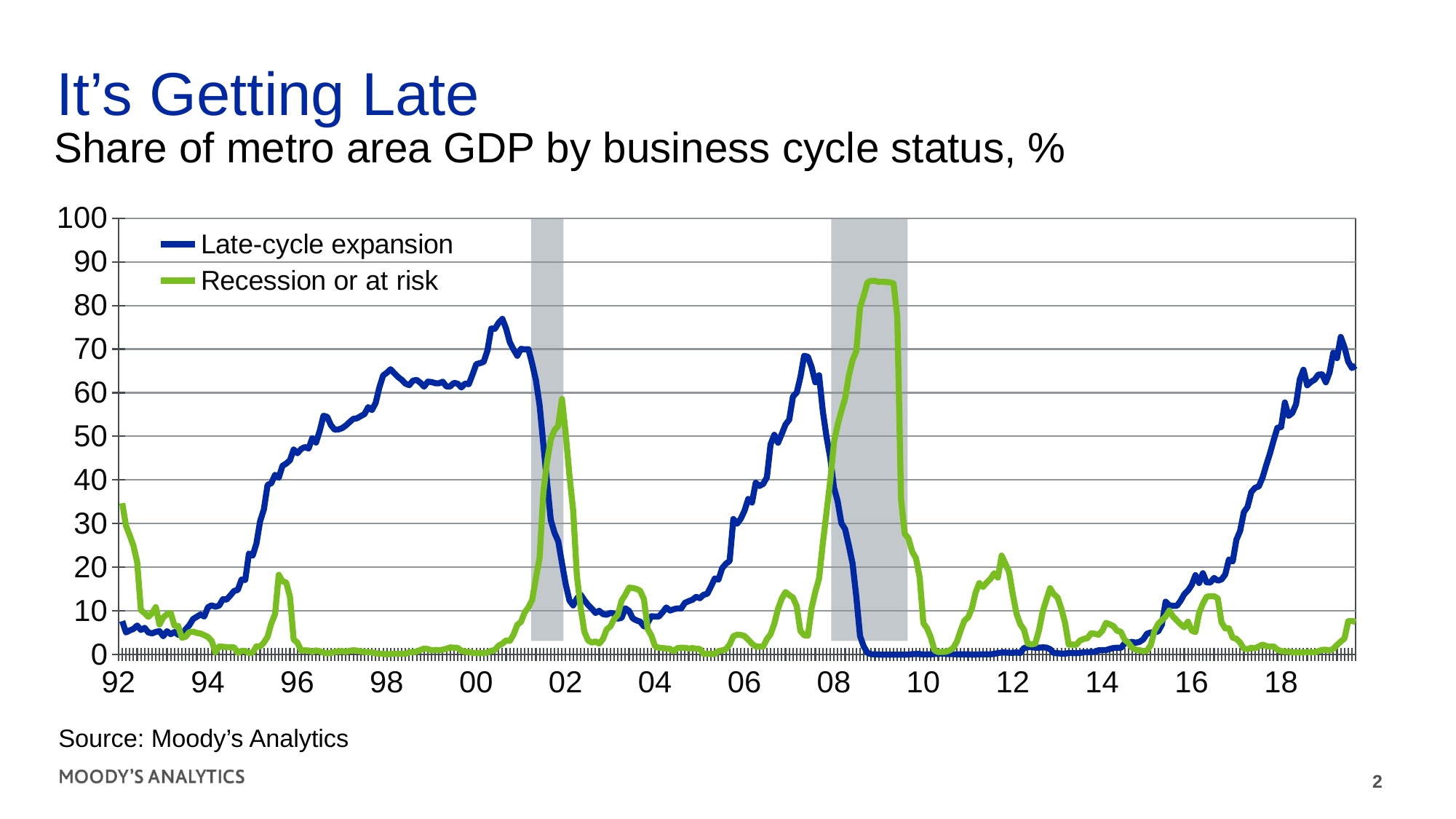
Is the value of Recession or at risk in 1998 greater or less than 10? less Is the value of Late-cycle expansion in 2012 greater or less than 10? less How many series does the legend list? 2 What kind of chart is shown on the slide? line chart Which series is drawn in green? Recession or at risk What is the subtitle describing what the chart plots? Share of metro area GDP by business cycle status, % Which series is higher in 2018, Late-cycle expansion or Recession or at risk? Late-cycle expansion Which series is higher in 2009, Late-cycle expansion or Recession or at risk? Recession or at risk Is the peak value of Late-cycle expansion around 2000 greater or less than 70? greater Which series reaches the highest peak anywhere on the chart? Recession or at risk